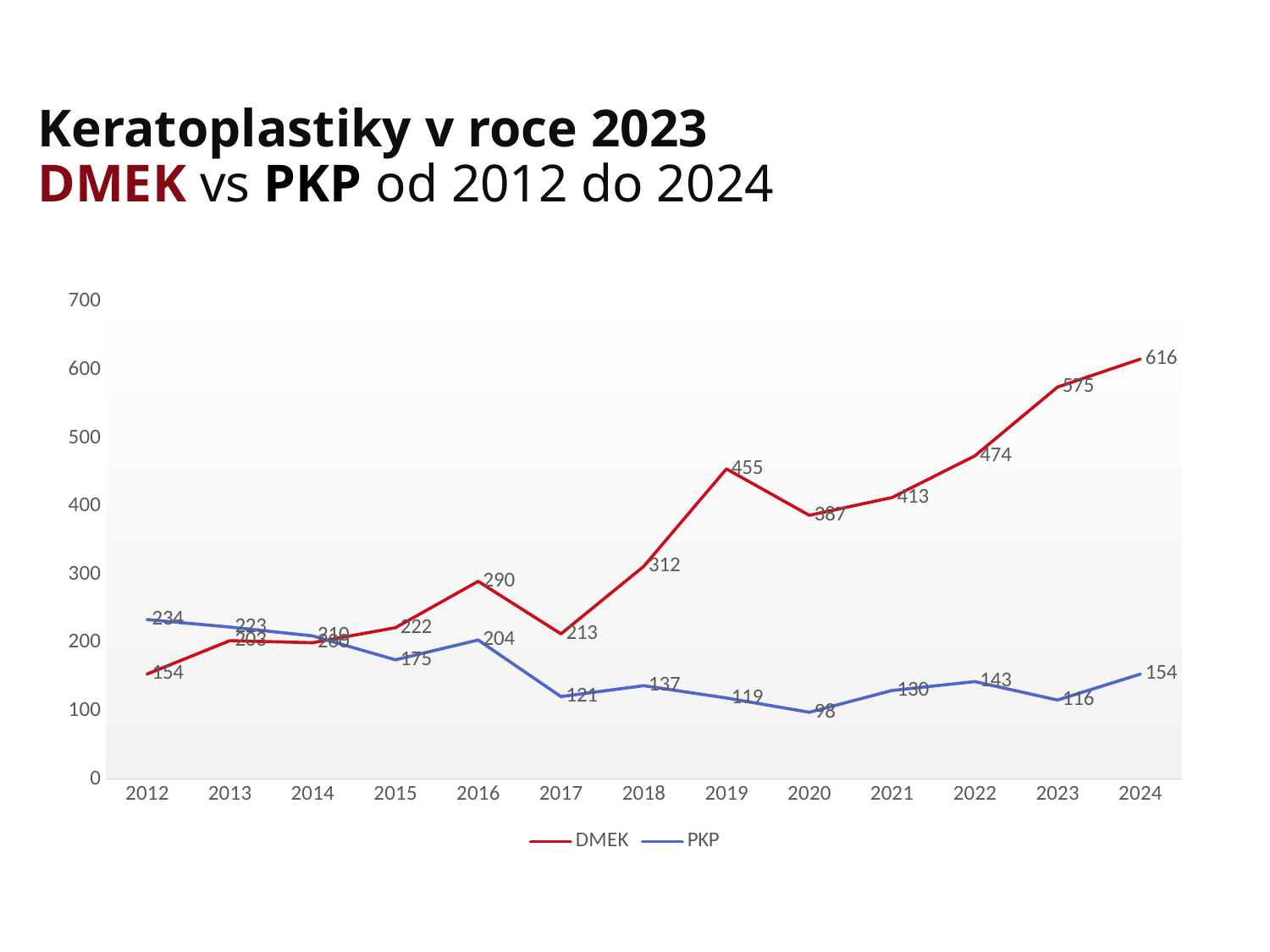
How many series does the legend list? 2 In which year is the DMEK value highest? 2024 What is the PKP value for 2020? 98 What is the DMEK value for 2019? 455 What is the difference between the DMEK and PKP values in 2024? 462 Does the DMEK series generally rise or fall from 2012 to 2024? Rise How many years are plotted on the x axis? 13 What is the difference between the DMEK values for 2024 and 2023? 41 What kind of chart is shown on the slide? Line chart In 2012, which series has the larger value, DMEK or PKP? PKP What is the DMEK value for 2024? 616 In which year is the PKP value lowest? 2020